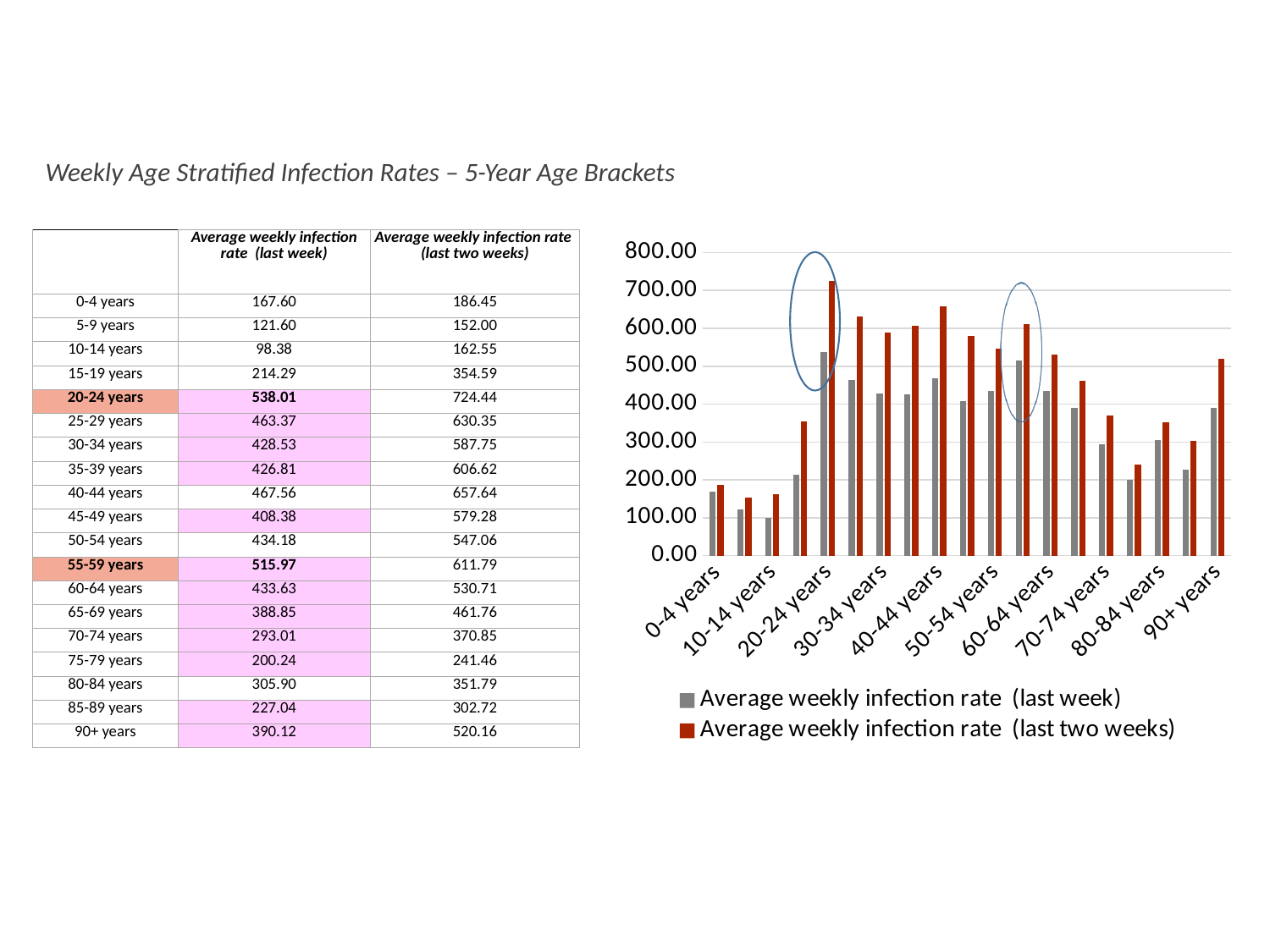
Which age bracket has the highest average weekly infection rate (last two weeks)? 20-24 years What is the average weekly infection rate (last two weeks) for 90+ years? 520.16 How many series does the chart's legend list? 2 What is the difference between the last two weeks and last week average infection rates for 20-24 years? 186.43 What is the average weekly infection rate (last week) for 20-24 years? 538.01 Which is larger: the average weekly infection rate (last week) for 55-59 years or for 60-64 years? 55-59 years Which age bracket has the lowest average weekly infection rate (last week)? 10-14 years How many age-bracket categories are plotted on the chart? 19 Do the average weekly infection rate (last week) values rise or fall from 0-4 years to 10-14 years? fall What kind of chart is shown on the slide? bar chart Is the average weekly infection rate (last week) for 10-14 years greater or less than 100? less Is the average weekly infection rate (last two weeks) for 20-24 years greater or less than 700? greater